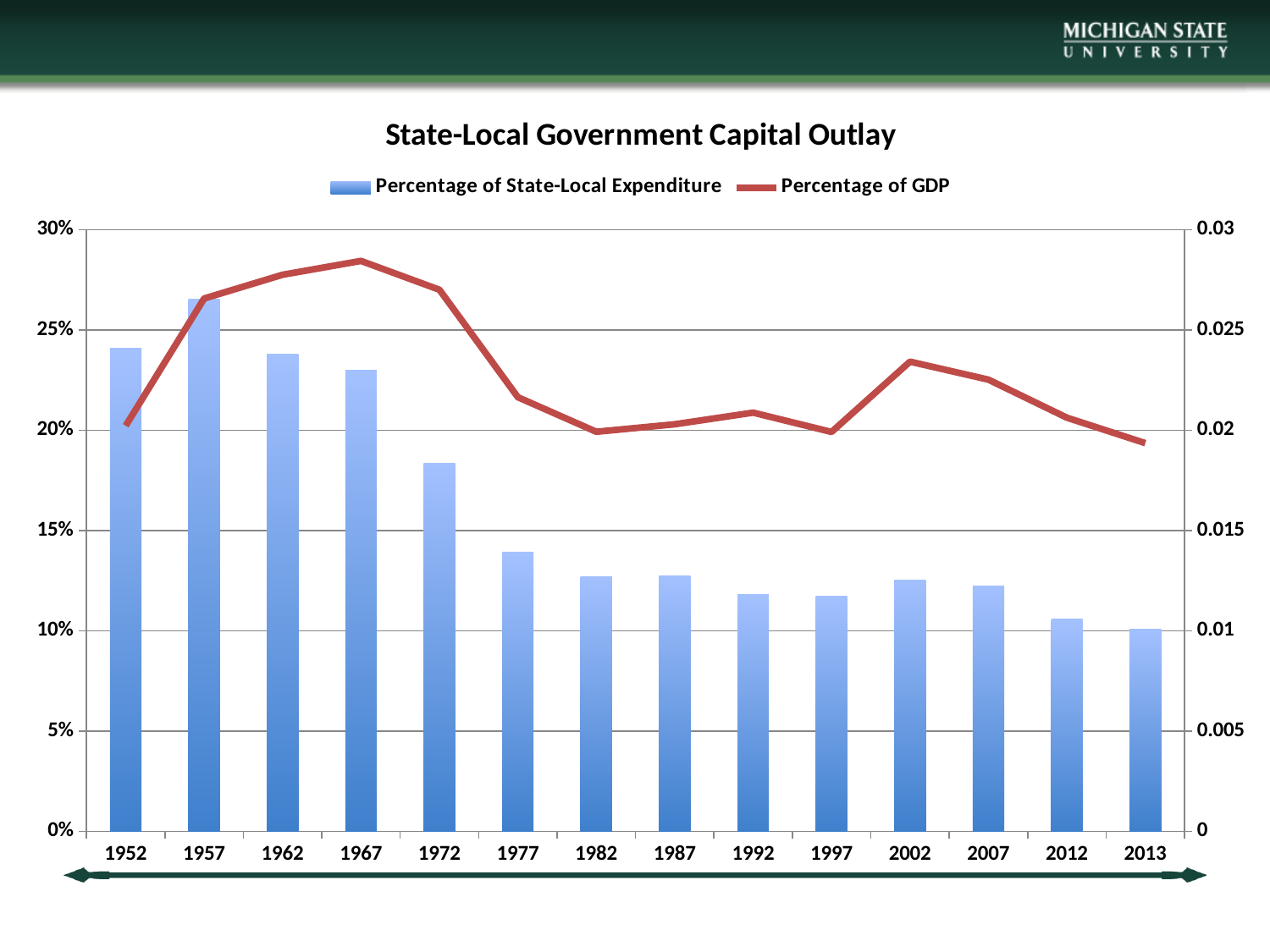
Is the Percentage of State-Local Expenditure for 1977 greater or less than 15%? less What is the title of the chart? State-Local Government Capital Outlay In which year is the Percentage of State-Local Expenditure bar the highest? 1957 Is the Percentage of State-Local Expenditure for 1972 greater or less than 20%? less What kind of chart is shown on the slide? A combined bar and line chart Which year has the larger Percentage of State-Local Expenditure, 1952 or 1972? 1952 Which series is drawn as a line? Percentage of GDP How many years are shown along the x axis? 14 In which year is the Percentage of State-Local Expenditure bar the lowest? 2013 In which year does the Percentage of GDP line reach its highest point? 1967 How many series does the legend list? 2 Is the Percentage of GDP for 1967 greater or less than 0.025? greater